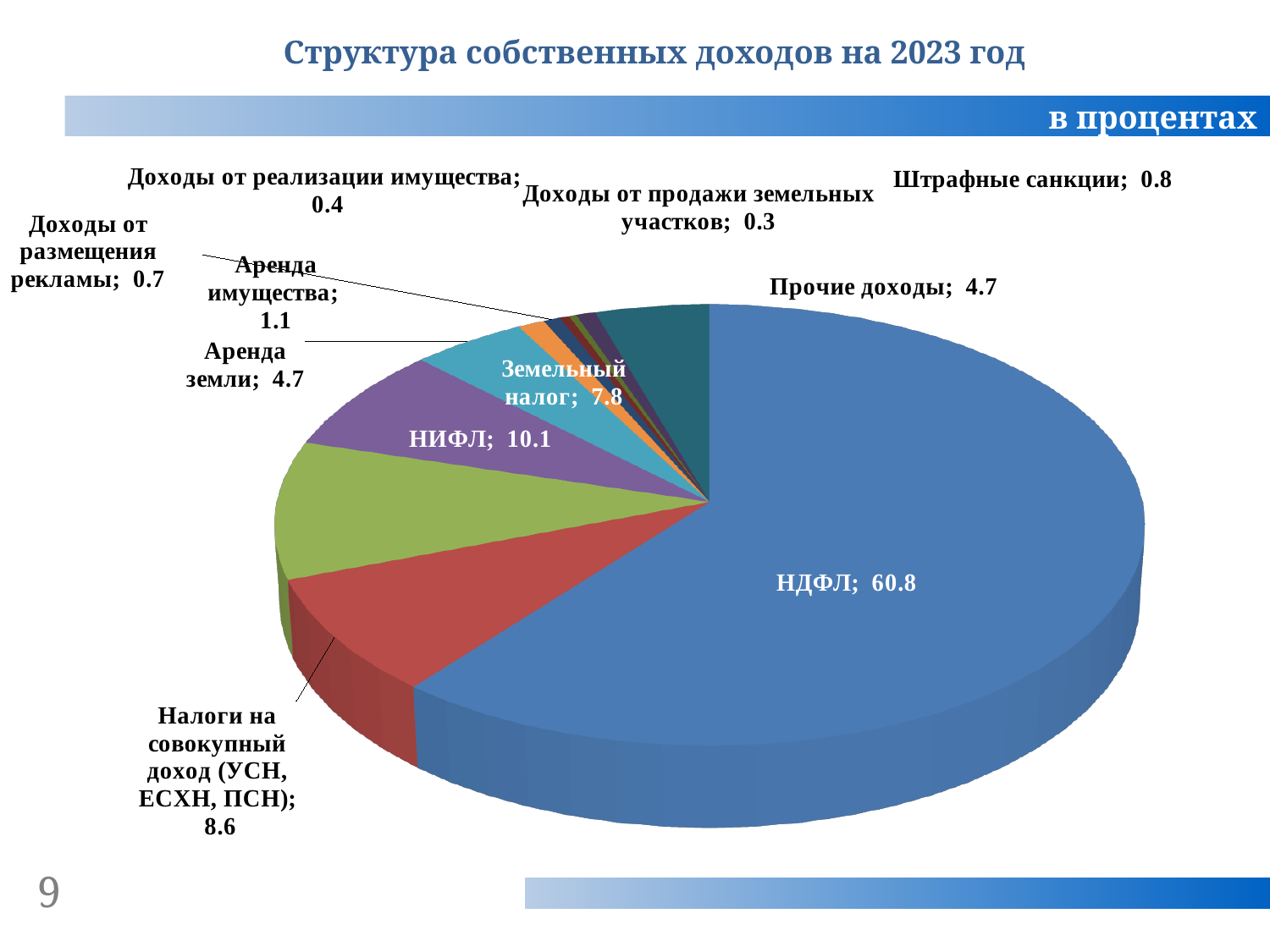
Which is larger, Аренда земли or Аренда имущества? Аренда земли Which category has the largest share of the pie? НДФЛ What kind of chart is shown on the slide? Pie chart Which category has the smallest share of the pie? Доходы от продажи земельных участков What is the value for НИФЛ? 10.1 What is the value for Штрафные санкции? 0.8 What is the difference between the values for НИФЛ and Земельный налог? 2.3 What is the value for НДФЛ? 60.8 What is the value for Налоги на совокупный доход (УСН, ЕСХН, ПСН)? 8.6 What is the title of the chart? Структура собственных доходов на 2023 год What is the value for Земельный налог? 7.8 How many categories are shown in the pie chart? 11